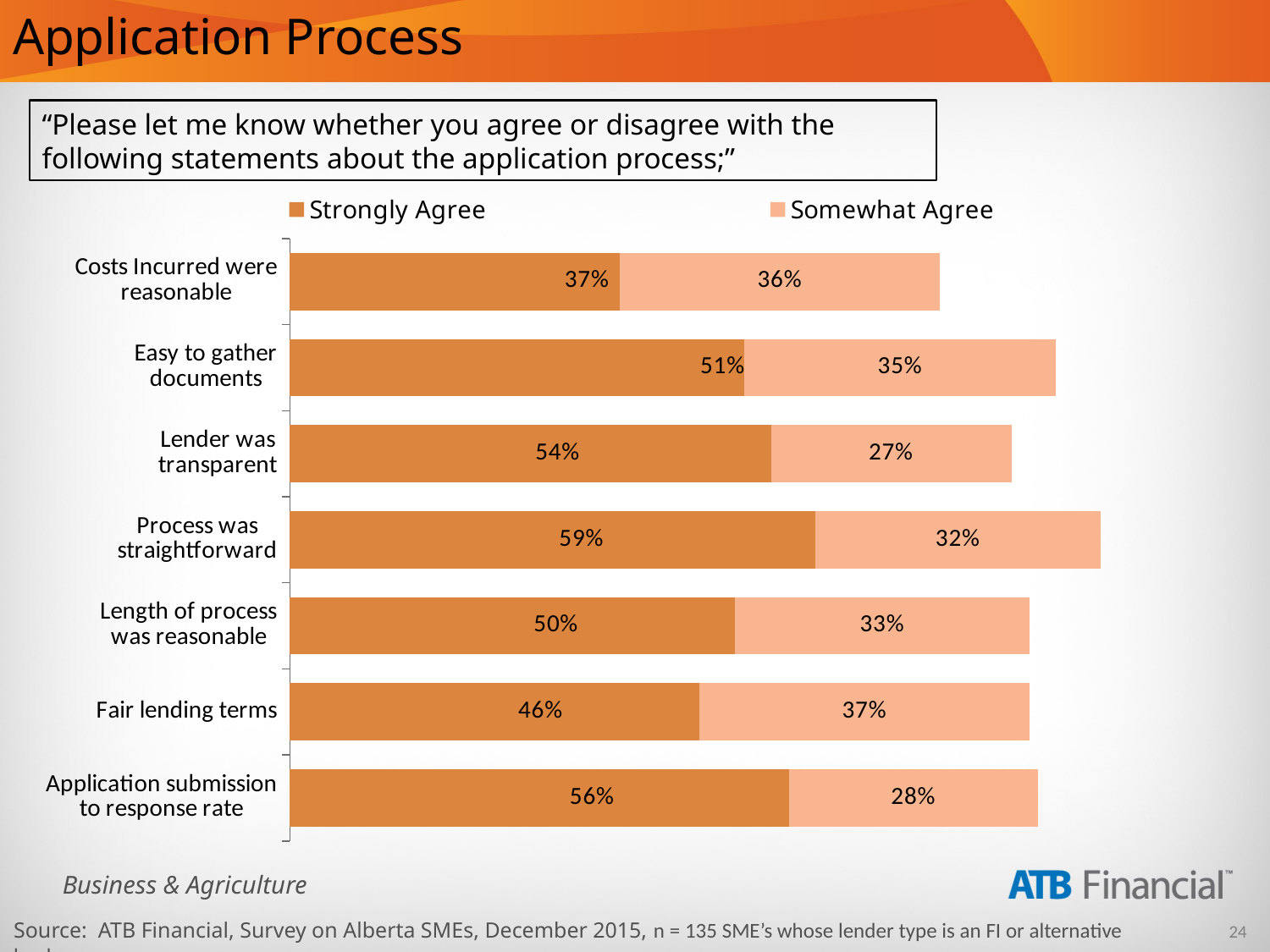
Which statement has the lowest Somewhat Agree percentage? Lender was transparent What is the combined Strongly Agree and Somewhat Agree total for 'Costs Incurred were reasonable'? 73% Which statement has the lowest Strongly Agree percentage? Costs Incurred were reasonable What is the difference between the Strongly Agree values for 'Application submission to response rate' and 'Easy to gather documents'? 5% What is the Strongly Agree value for 'Fair lending terms'? 46% Which is larger: the Strongly Agree value for 'Lender was transparent' or for 'Length of process was reasonable'? Lender was transparent What is the combined Strongly Agree and Somewhat Agree total for 'Process was straightforward'? 91% How many statements are shown in the chart? 7 How many series does the legend list? 2 What percentage of respondents somewhat agree that the lender was transparent? 27% Which statement has the highest Strongly Agree percentage? Process was straightforward What percentage of respondents strongly agree that the process was straightforward? 59%